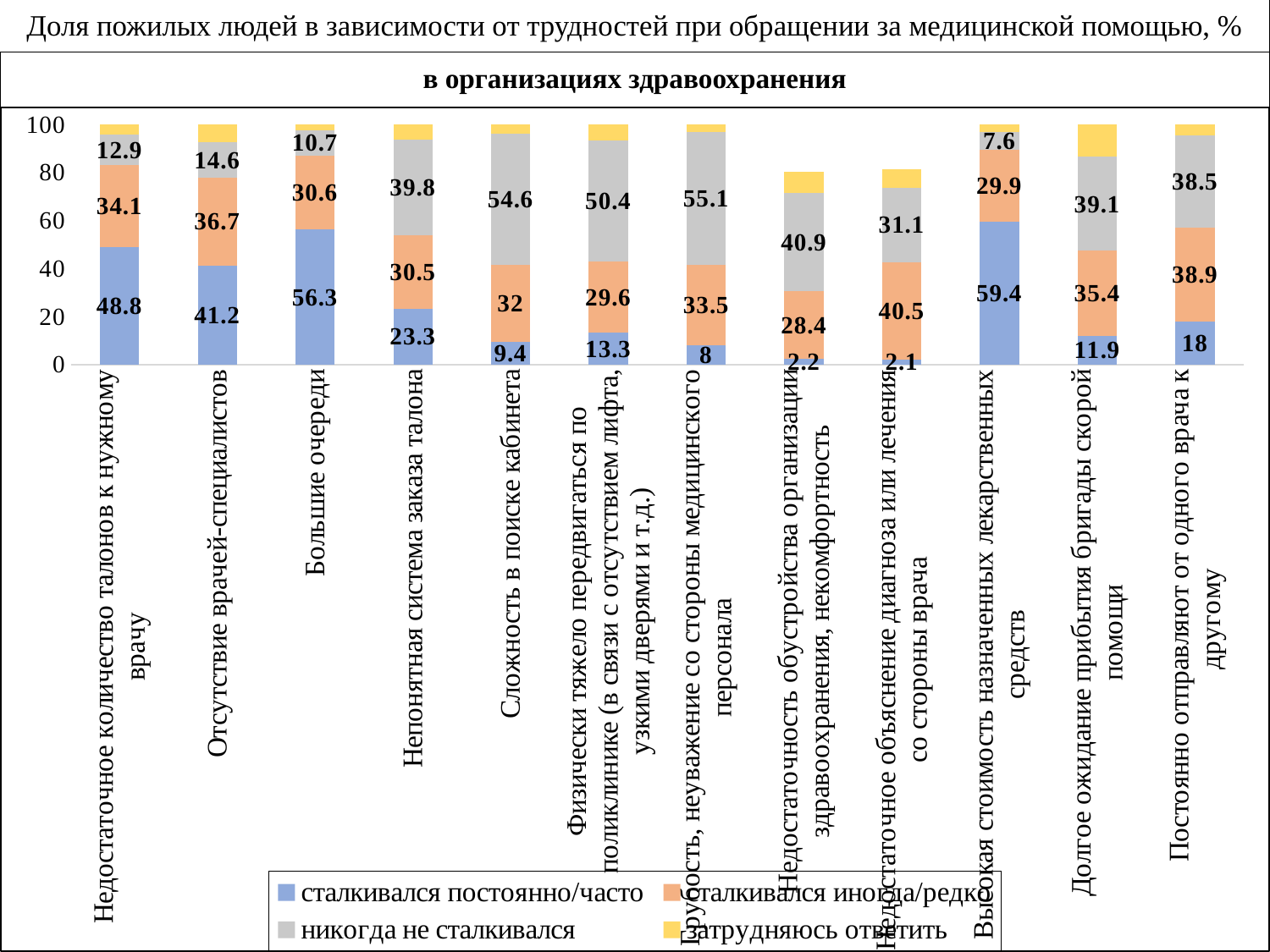
What is the value of 'сталкивался иногда/редко' for 'Недостаточное объяснение диагноза или лечения со стороны врача'? 40.5 What share of elderly people reported constantly/often facing 'Недостаточное количество талонов к нужному врачу' (сталкивался постоянно/часто)? 48.8 Is the 'сталкивался постоянно/часто' value for 'Большие очереди' greater or less than 40? greater What is the difference between the 'сталкивался постоянно/часто' values for 'Большие очереди' and 'Непонятная система заказа талона'? 33 Which is larger for 'Недостаточное объяснение диагноза или лечения со стороны врача': 'сталкивался иногда/редко' or 'никогда не сталкивался'? сталкивался иногда/редко What type of chart is shown on the slide? stacked bar chart What is the value of 'сталкивался постоянно/часто' for 'Постоянно отправляют от одного врача к другому'? 18 How many series does the legend list? 4 What is the value of 'никогда не сталкивался' for 'Сложность в поиске кабинета'? 54.6 Which difficulty has the lowest value for 'никогда не сталкивался'? Высокая стоимость назначенных лекарственных средств Which difficulty has the highest value for 'сталкивался постоянно/часто'? Высокая стоимость назначенных лекарственных средств How many difficulty categories are shown on the x axis? 12